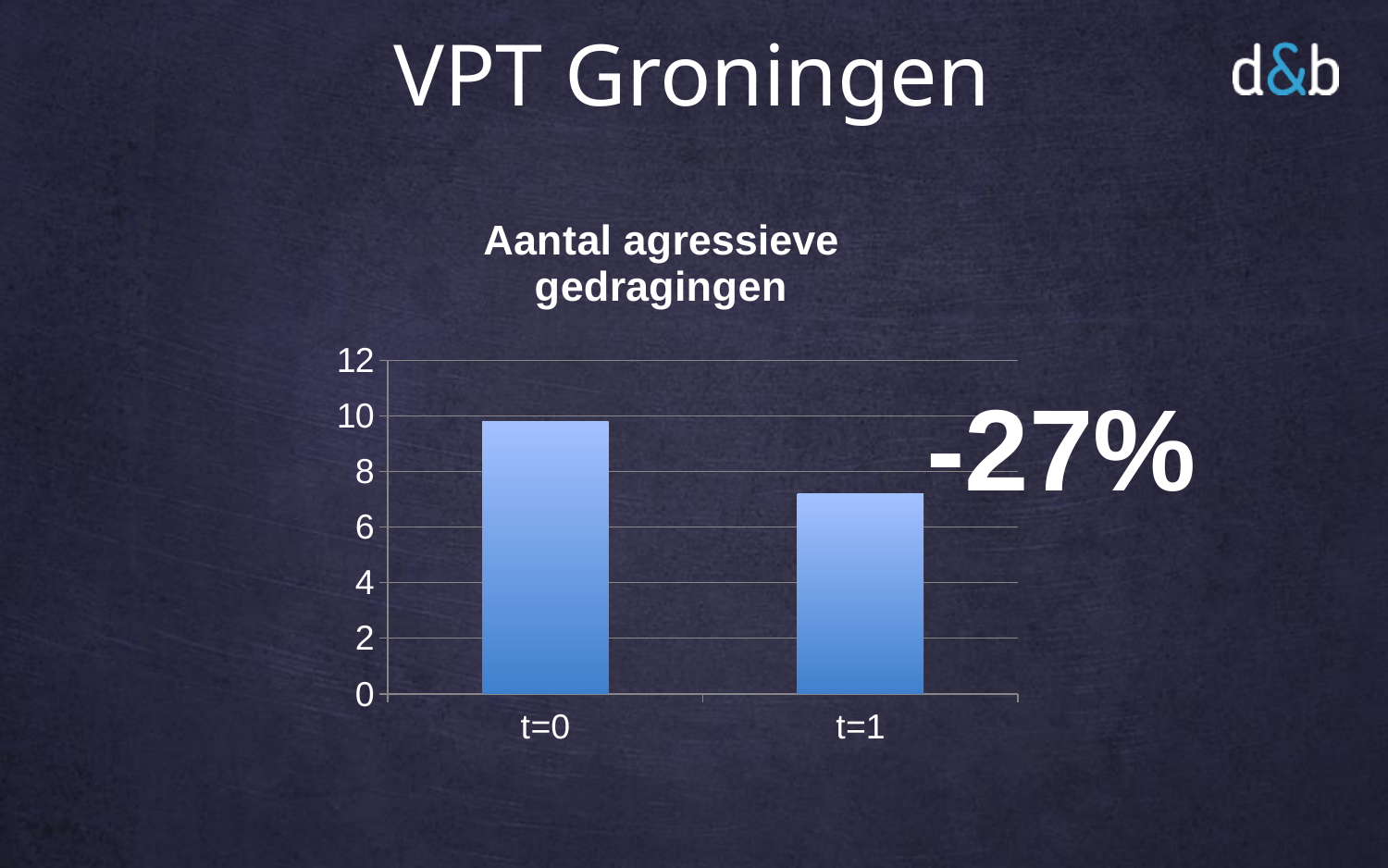
Is the value for t=1 greater or less than 8? less Is the value for t=0 greater or less than 10? less Which category has the highest value? t=0 Do the values rise or fall from t=0 to t=1? fall What percentage change is printed next to the chart? -27% What is the title of the chart? Aantal agressieve gedragingen Is the value for t=0 greater or less than 8? greater Which category has the lowest value? t=1 Which is larger, the value for t=0 or the value for t=1? t=0 How many bars does the chart show? 2 What kind of chart is shown on the slide? bar chart